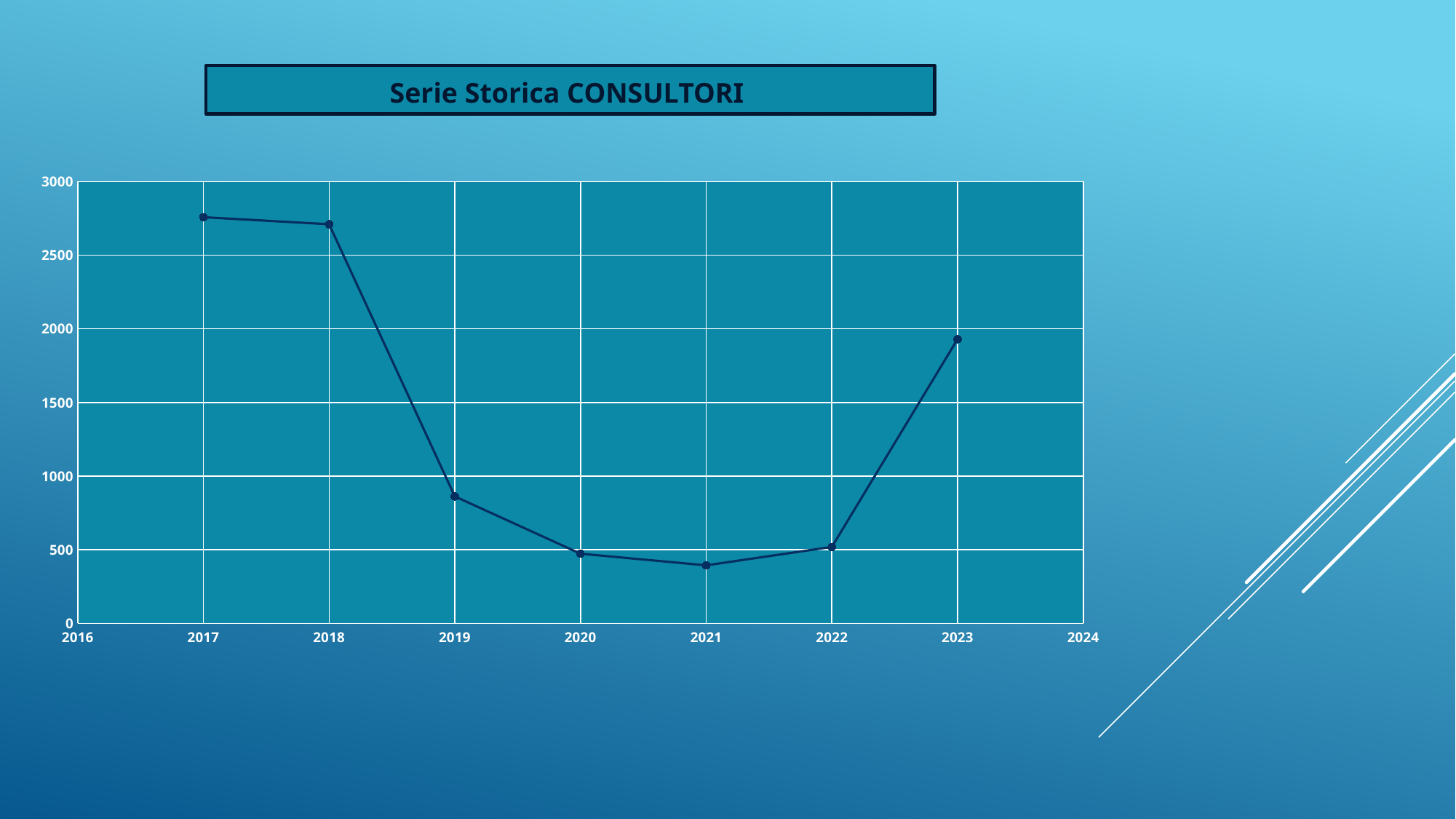
What is the title of the chart? Serie Storica CONSULTORI Is the value for 2018 greater or less than 2500? greater What kind of chart is shown on the slide? line chart Do the values rise or fall from 2018 to 2021? fall How many data points are plotted on the line? 7 Is the value for 2021 greater or less than 500? less Which year has the larger value, 2019 or 2023? 2023 Is the value for 2017 greater or less than 2500? greater Which year has the lowest value? 2021 Which year has the larger value, 2018 or 2019? 2018